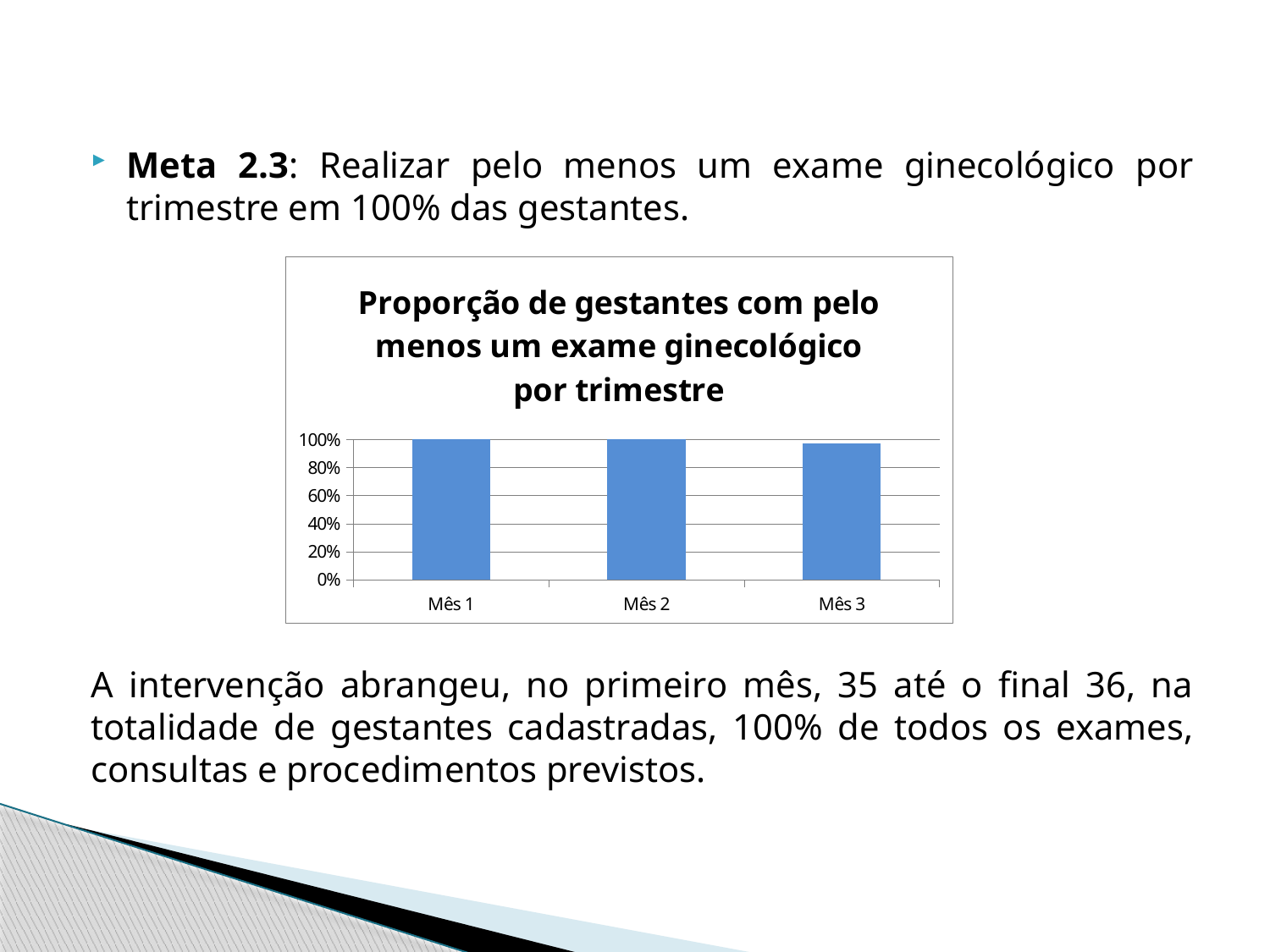
What is the title of the chart? Proporção de gestantes com pelo menos um exame ginecológico por trimestre Which month has the lowest value in the chart? Mês 3 What kind of chart is shown on the slide? Bar chart Is the value for Mês 3 greater or less than 80%? greater What is the highest value shown on the y axis of the chart? 100% What is the value for Mês 2 in the chart? 100% Is the value for Mês 1 greater or less than 60%? greater How many categories (months) are shown on the x axis of the chart? 3 What is the label of the first category on the x axis? Mês 1 What is the value for Mês 1 in the chart? 100% Which is larger, the value for Mês 1 or the value for Mês 3? Mês 1